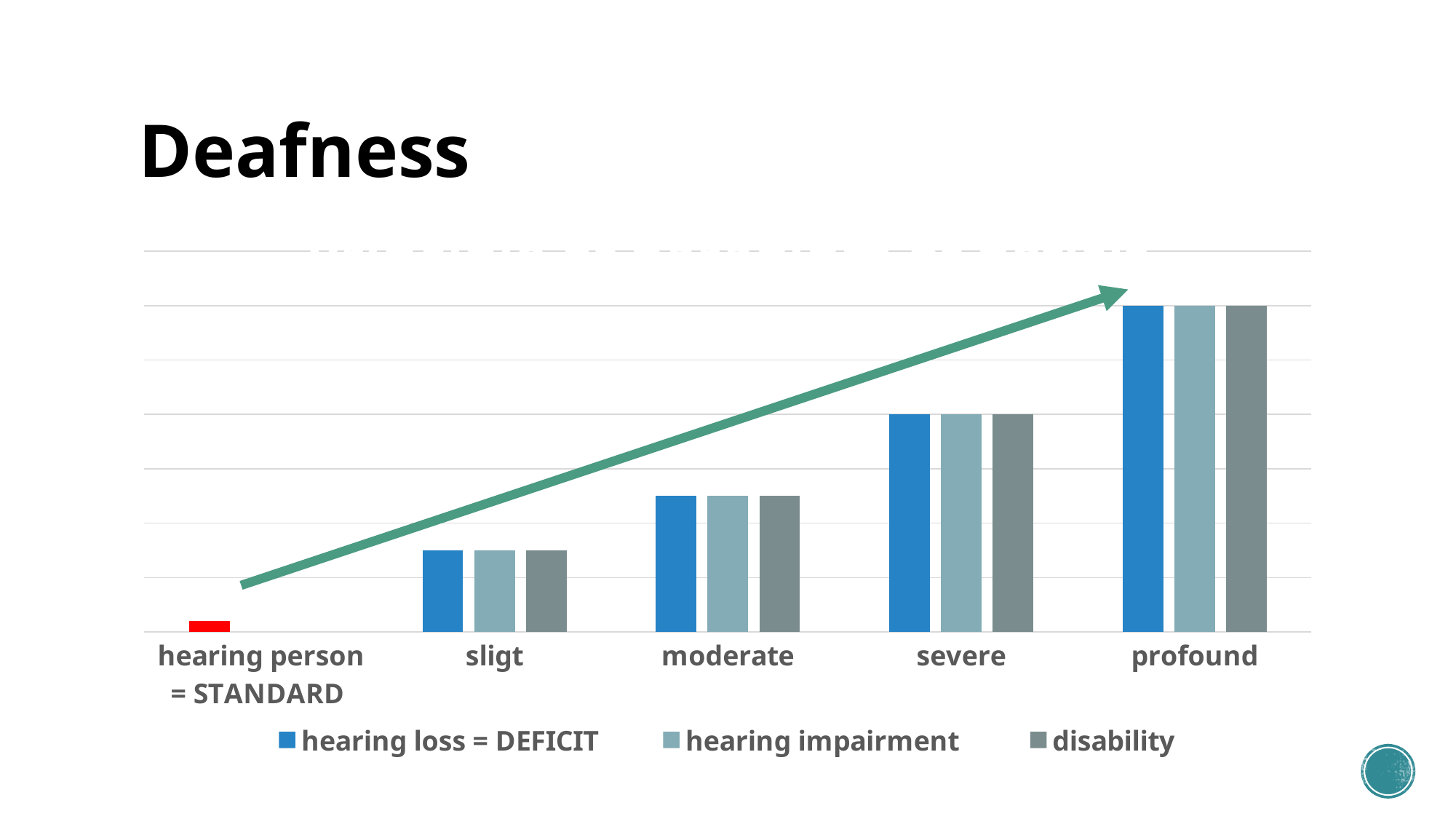
Which is larger, the 'hearing impairment' bar for moderate or for sligt? moderate What colour is the bar for the 'hearing person = STANDARD' category? red How many categories are shown along the x axis of the chart? 5 How many series does the chart's legend list? 3 Which category has the tallest bars in the chart? profound Do the bar heights rise or fall moving from left to right along the x axis? rise What is the first series listed in the chart's legend? hearing loss = DEFICIT Which is larger, the 'hearing loss = DEFICIT' bar for severe or for moderate? severe Which is larger, the 'disability' bar for sligt or for profound? profound Which category has the lowest bar in the chart? hearing person = STANDARD What kind of chart is shown on the slide? bar chart